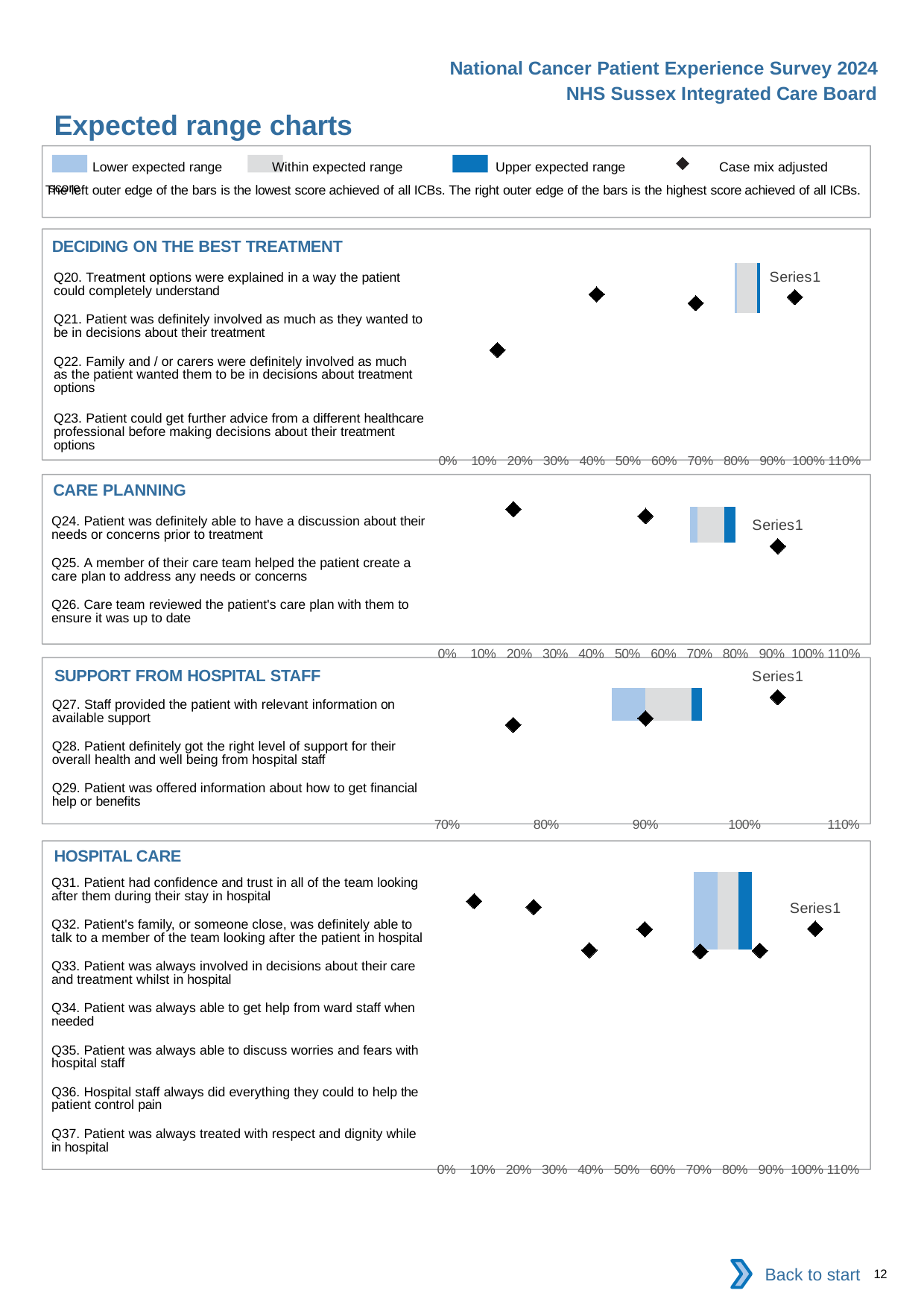
How many questions are listed in the CARE PLANNING chart? 3 What is the title of the first chart on the slide? DECIDING ON THE BEST TREATMENT In the SUPPORT FROM HOSPITAL STAFF chart, is the lowest plotted case mix adjusted score greater or less than 80%? less How many questions are listed in the SUPPORT FROM HOSPITAL STAFF chart? 3 What kind of chart is used in the HOSPITAL CARE section? Bar chart How many questions are listed in the HOSPITAL CARE chart? 7 In the DECIDING ON THE BEST TREATMENT chart, is the lowest plotted case mix adjusted score greater or less than 20%? less In the HOSPITAL CARE chart, is the lowest plotted case mix adjusted score greater or less than 10%? less In the SUPPORT FROM HOSPITAL STAFF chart, what is the lowest value shown on the x axis? 70% How many entries does the legend at the top of the slide list? 4